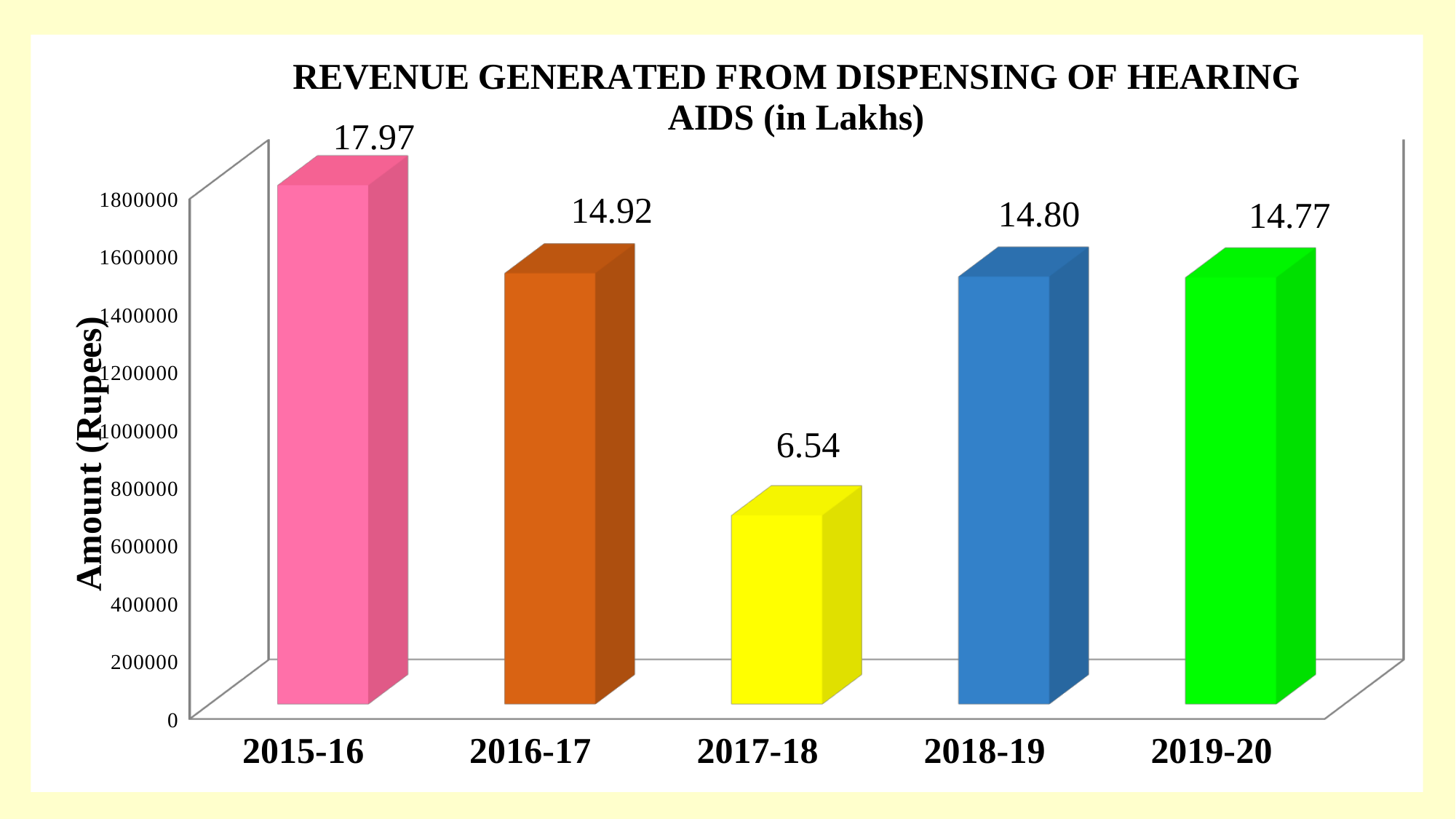
Which is larger, the value for 2015-16 or the value for 2016-17? 2015-16 Which year has the highest revenue? 2015-16 What is the difference between the data labels for 2015-16 and 2016-17? 3.05 What is the data label for 2015-16? 17.97 Is the bar for 2017-18 greater or less than 800000 on the y axis? less What kind of chart is this? bar chart What is the data label for 2019-20? 14.77 Does the value rise or fall from 2017-18 to 2018-19? rise What is the data label for 2017-18? 6.54 Which year has the lowest revenue? 2017-18 What is the difference between the data labels for 2018-19 and 2017-18? 8.26 How many years are shown on the x axis? 5